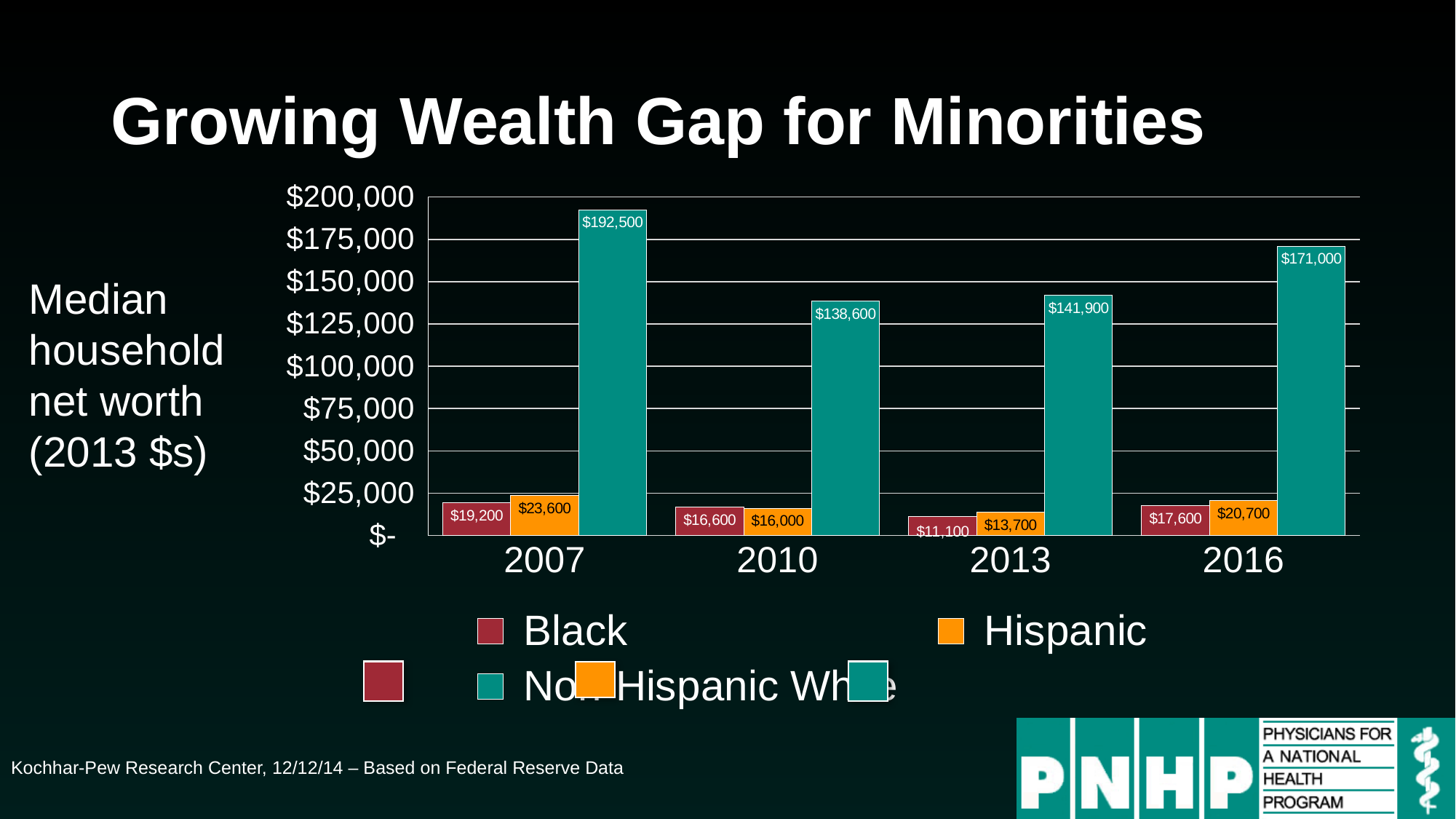
How many series does the legend list? 3 What is the median household net worth for Non-Hispanic White households in 2007? $192,500 Is the Non-Hispanic White value for 2013 greater or less than $125,000? greater Which is larger in 2010, the Black value or the Hispanic value? Black What is the title of the slide? Growing Wealth Gap for Minorities In which year is the Non-Hispanic White value the highest? 2007 What is the difference between the Non-Hispanic White value and the Black value in 2016? $153,400 What is the value for Black households in 2013? $11,100 In which year is the Black value the lowest? 2013 What is the value for Hispanic households in 2016? $20,700 What kind of chart is shown on the slide? bar chart How many years are shown on the x axis? 4